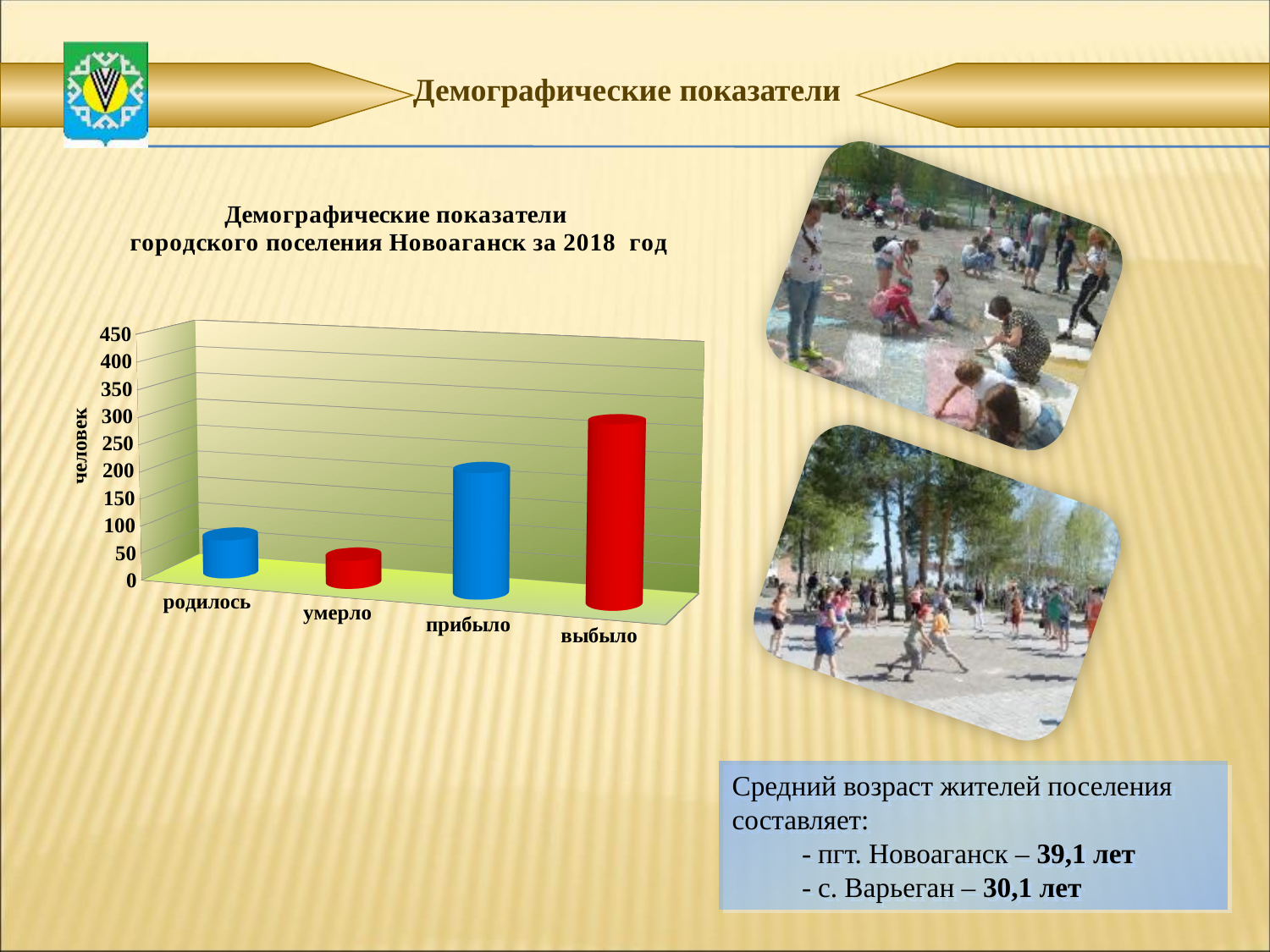
Which is larger, the value for прибыло or the value for родилось? прибыло Is the value for выбыло greater or less than 200? greater Which category has the highest value on the chart? выбыло Is the value for прибыло greater or less than 100? greater What is the label on the vertical axis of the chart? человек Is the value for умерло greater or less than 100? less Which is larger, the value for выбыло or the value for умерло? выбыло What kind of chart is shown on the slide? bar chart Which category has the lowest value on the chart? умерло How many categories are plotted on the chart? 4 What is the title of the chart? Демографические показатели городского поселения Новоаганск за 2018 год